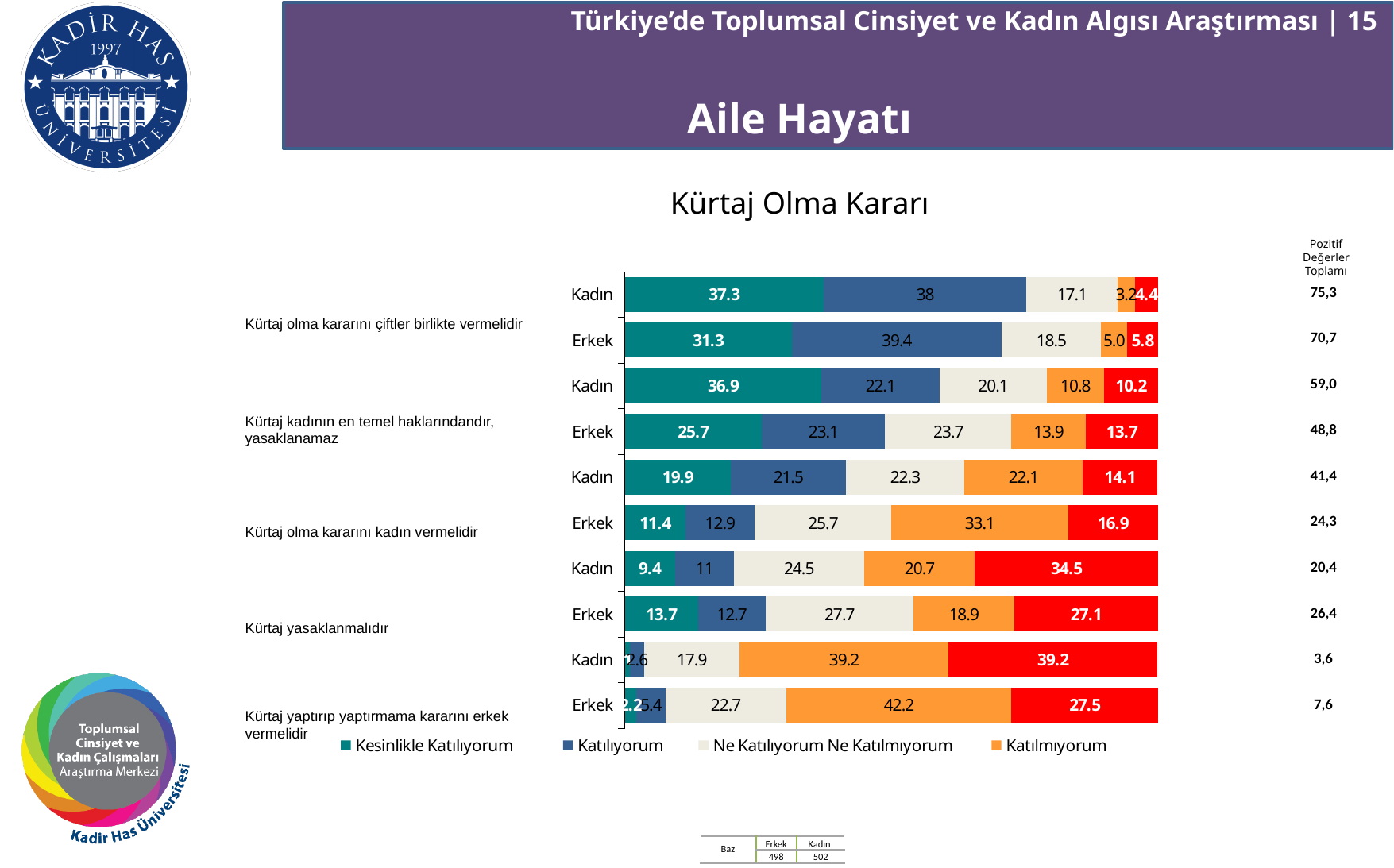
What is the "Pozitif Değerler Toplamı" for Kadın on the statement "Kürtaj kadının en temel haklarındandır, yasaklanamaz"? 59,0 Which Kadın/Erkek row has the highest "Pozitif Değerler Toplamı"? Kadın, Kürtaj olma kararını çiftler birlikte vermelidir (75,3) How many bars (Kadın/Erkek rows) does the chart show? 10 What is the "Katılıyorum" value for Erkek on the statement "Kürtaj olma kararını çiftler birlikte vermelidir"? 39.4 Which Kadın/Erkek row has the lowest "Pozitif Değerler Toplamı"? Kadın, Kürtaj yaptırıp yaptırmama kararını erkek vermelidir (3,6) What is the "Kesinlikle Katılıyorum" value for Kadın on the statement "Kürtaj olma kararını çiftler birlikte vermelidir"? 37.3 What kind of chart is shown under the title "Kürtaj Olma Kararı"? Stacked bar chart On the statement "Kürtaj yasaklanmalıdır", is the red (rightmost) segment larger for Kadın or for Erkek? Kadın What is the difference between the "Kesinlikle Katılıyorum" values for Kadın (36.9) and Erkek (25.7) on the statement "Kürtaj kadının en temel haklarındandır, yasaklanamaz"? 11.2 What is the first legend entry of the chart? Kesinlikle Katılıyorum What is the "Katılmıyorum" value for Erkek on the statement "Kürtaj olma kararını kadın vermelidir"? 33.1 How many series does the legend list? 4